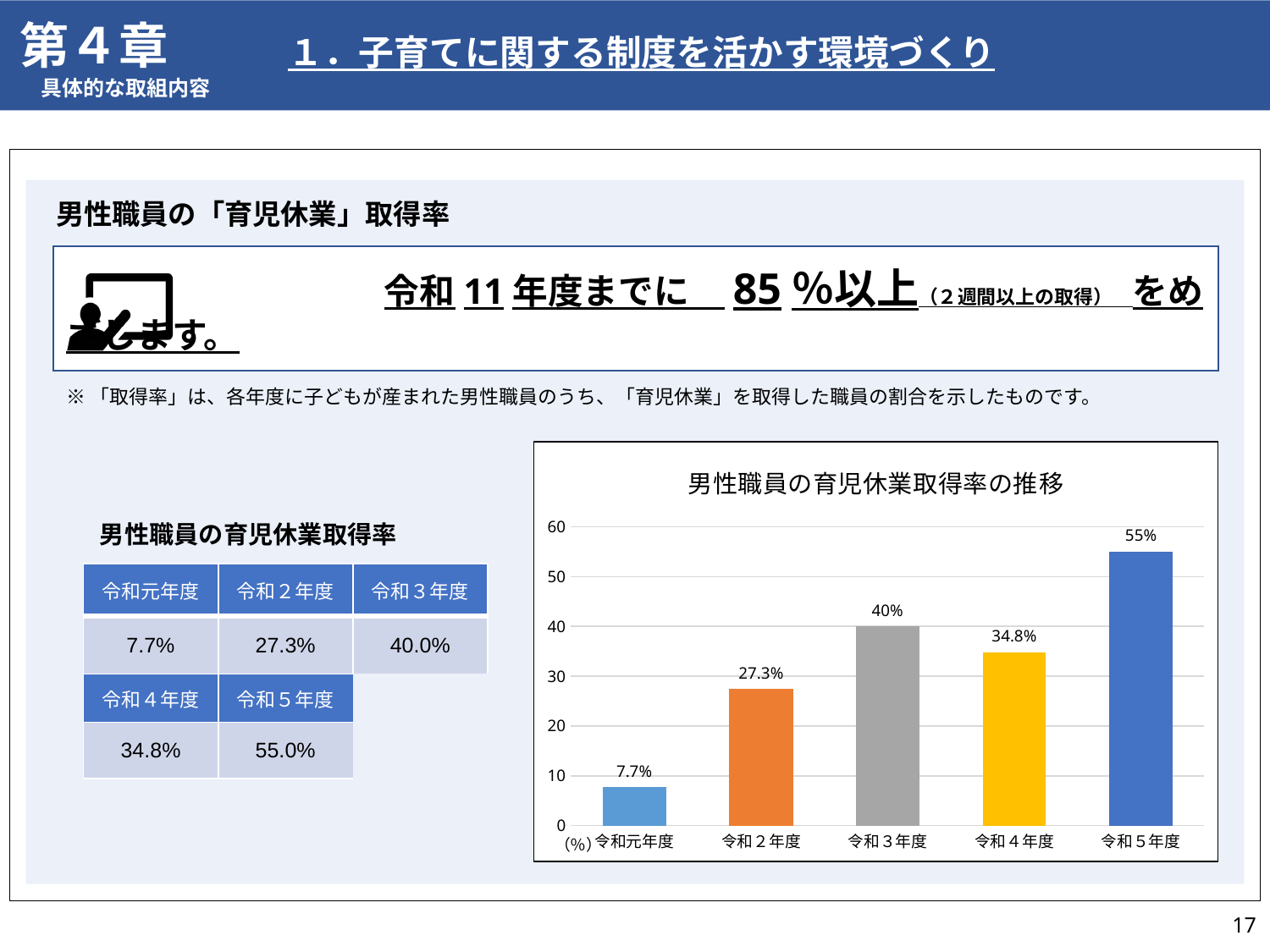
What is the difference between the values for 令和５年度 and 令和４年度? 20.2% What is the title of the chart? 男性職員の育児休業取得率の推移 How many years (bars) are shown in the chart? 5 Which year has the lowest value in the chart? 令和元年度 Is the value for 令和２年度 greater or less than 30? less What is the value for 令和４年度 in the chart? 34.8% What is the difference between the values for 令和２年度 and 令和元年度? 19.6% Which is larger, the value for 令和３年度 or 令和４年度? 令和３年度 Which year has the highest value in the chart? 令和５年度 What is the value for 令和元年度 in the chart? 7.7% What is the value for 令和３年度 in the chart? 40% What kind of chart is shown on the slide? bar chart